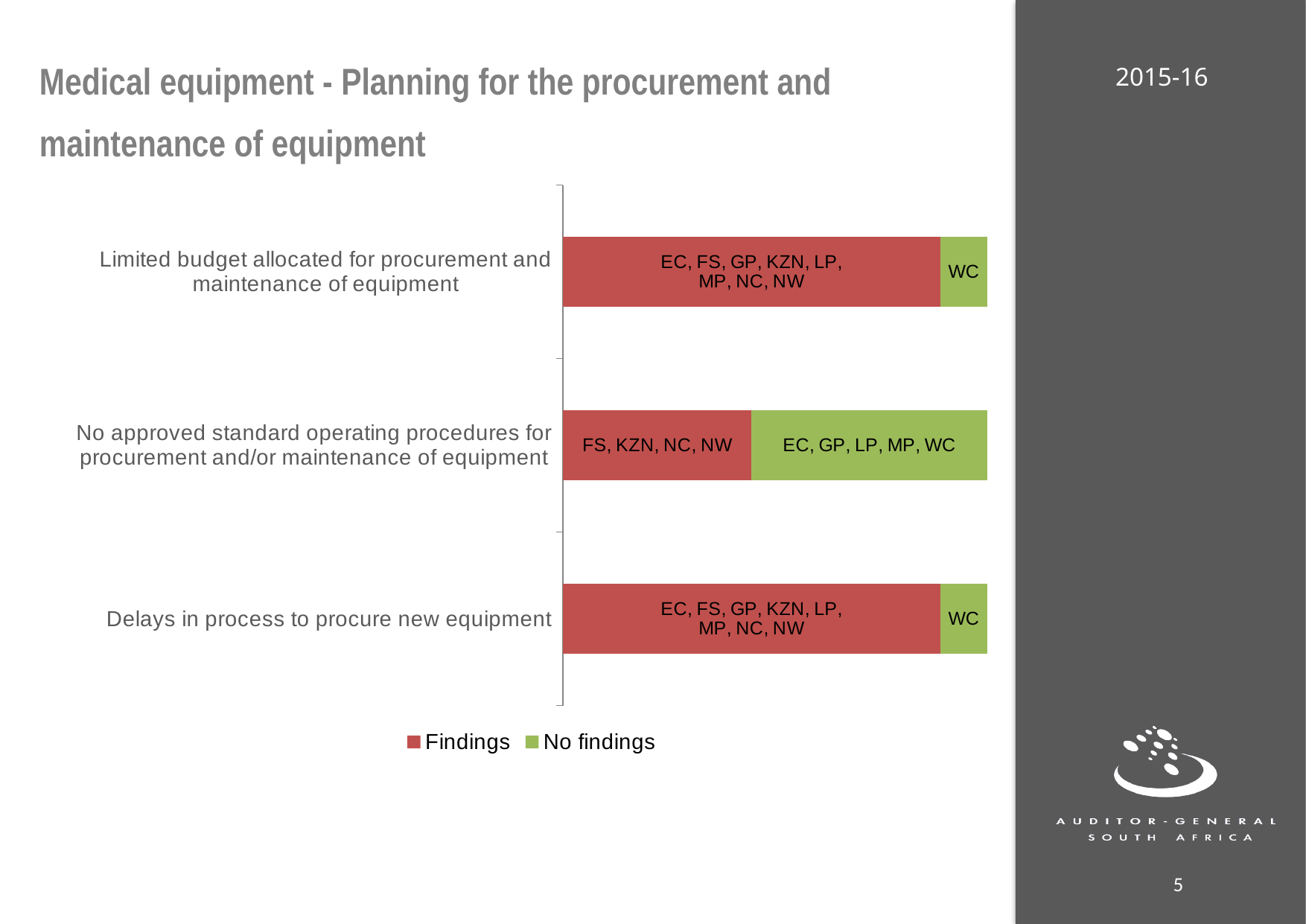
How many provinces are listed in the Findings segment for 'No approved standard operating procedures for procurement and/or maintenance of equipment'? 4 Which provinces are listed in the Findings segment for 'No approved standard operating procedures for procurement and/or maintenance of equipment'? FS, KZN, NC, NW What are the two series named in the legend? Findings and No findings Which provinces are listed in the Findings segment for 'Limited budget allocated for procurement and maintenance of equipment'? EC, FS, GP, KZN, LP, MP, NC, NW How many series does the legend list? 2 For 'No approved standard operating procedures for procurement and/or maintenance of equipment', which segment is larger: Findings or No findings? No findings Which province is listed in the No findings segment for 'Delays in process to procure new equipment'? WC How many categories (findings) are plotted on the chart? 3 What kind of chart is shown on the slide? Stacked horizontal bar chart What colour represents the Findings series? Red Which category has the smallest Findings segment? No approved standard operating procedures for procurement and/or maintenance of equipment Which provinces are listed in the No findings segment for 'No approved standard operating procedures for procurement and/or maintenance of equipment'? EC, GP, LP, MP, WC